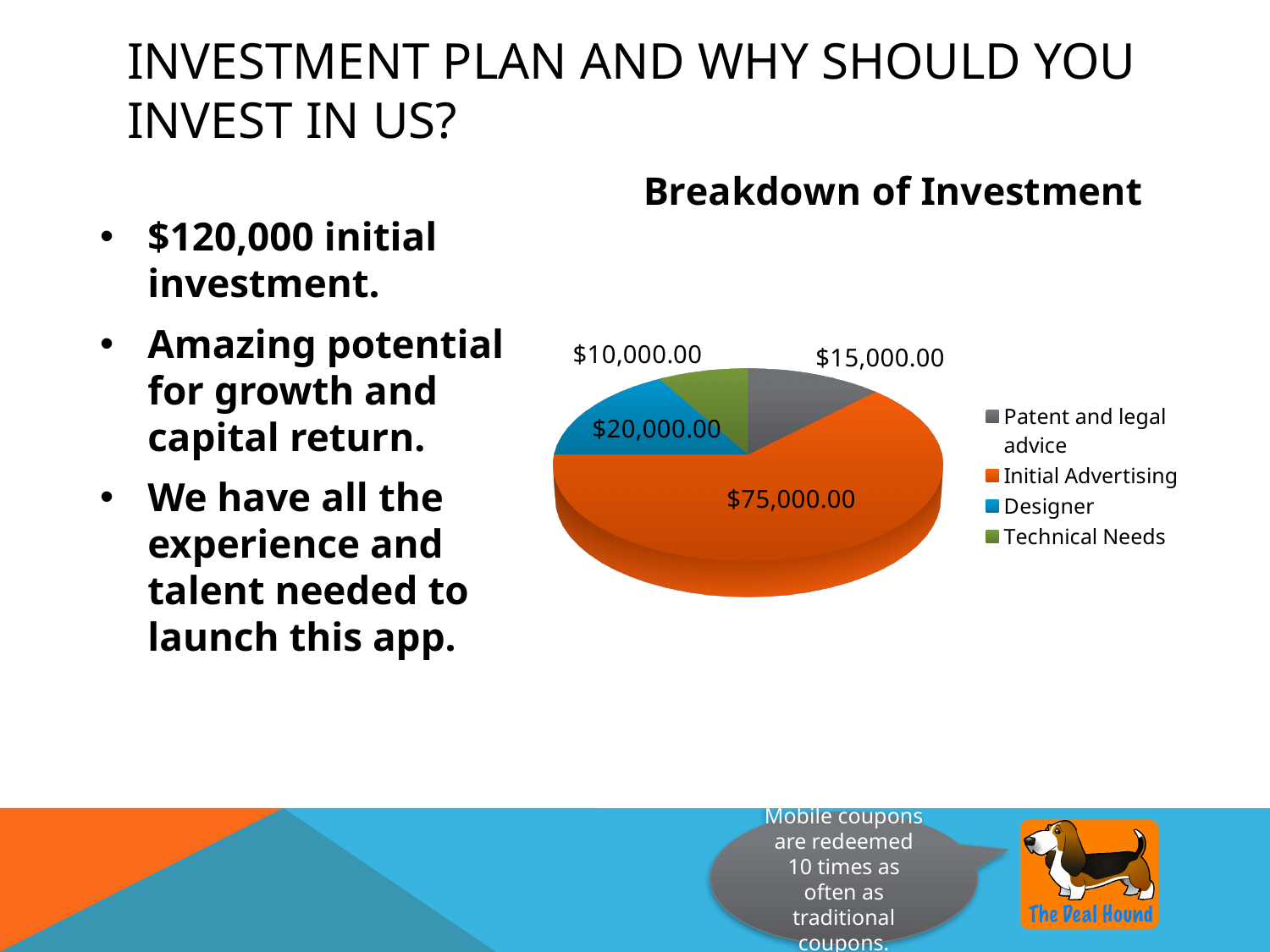
Which category has the largest slice in the Breakdown of Investment pie chart? Initial Advertising What is the difference between the Initial Advertising and Designer values in the Breakdown of Investment pie chart? $55,000.00 What is the value of the Technical Needs slice in the Breakdown of Investment pie chart? $10,000.00 What share of the total investment does the Initial Advertising slice represent in the Breakdown of Investment pie chart? 62.5% What is the value of the Designer slice in the Breakdown of Investment pie chart? $20,000.00 How many categories does the Breakdown of Investment pie chart show? 4 What colour is the Designer slice in the Breakdown of Investment pie chart? Blue What is the value of the Patent and legal advice slice in the Breakdown of Investment pie chart? $15,000.00 Which category has the smallest slice in the Breakdown of Investment pie chart? Technical Needs What is the value of the Initial Advertising slice in the Breakdown of Investment pie chart? $75,000.00 Which is larger in the Breakdown of Investment pie chart, Designer or Patent and legal advice? Designer What kind of chart is shown under the title "Breakdown of Investment"? Pie chart